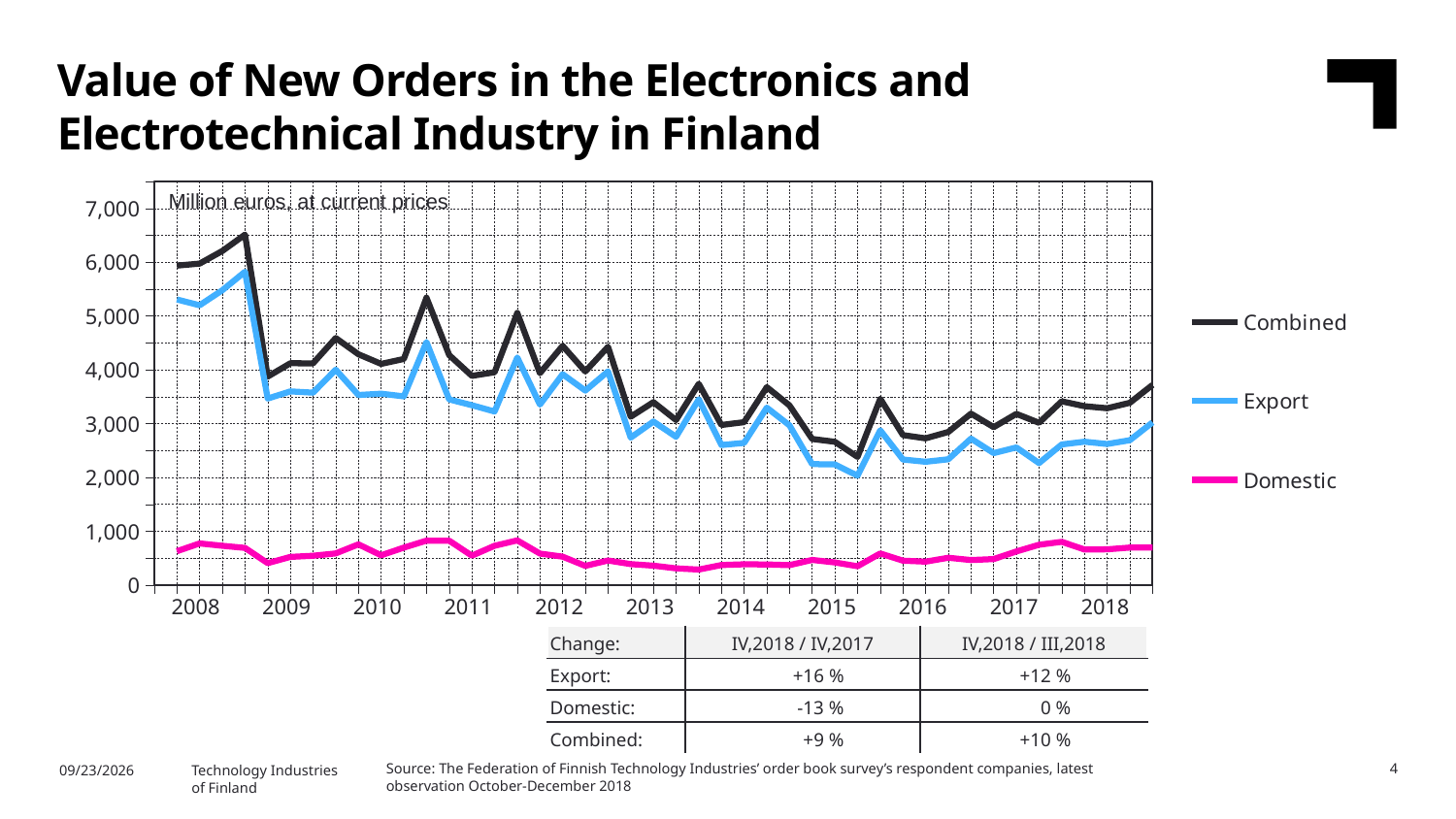
Which series has higher values in 2017, Export or Domestic? Export How many series does the chart legend list? 3 Is the Export value in 2015 greater or less than 3,000? less Which series is plotted with the lowest values throughout the chart? Domestic How many years are labelled on the x axis? 11 Is the Domestic value in 2018 greater or less than 1,000? less Does the Combined series overall rise or fall from 2008 to 2018? Fall Is the peak Combined value in 2008 greater or less than 6,000? greater Which series is plotted with the highest values throughout the chart? Combined What unit is stated at the top of the chart area? Million euros, at current prices What kind of chart is shown on the slide? Line chart